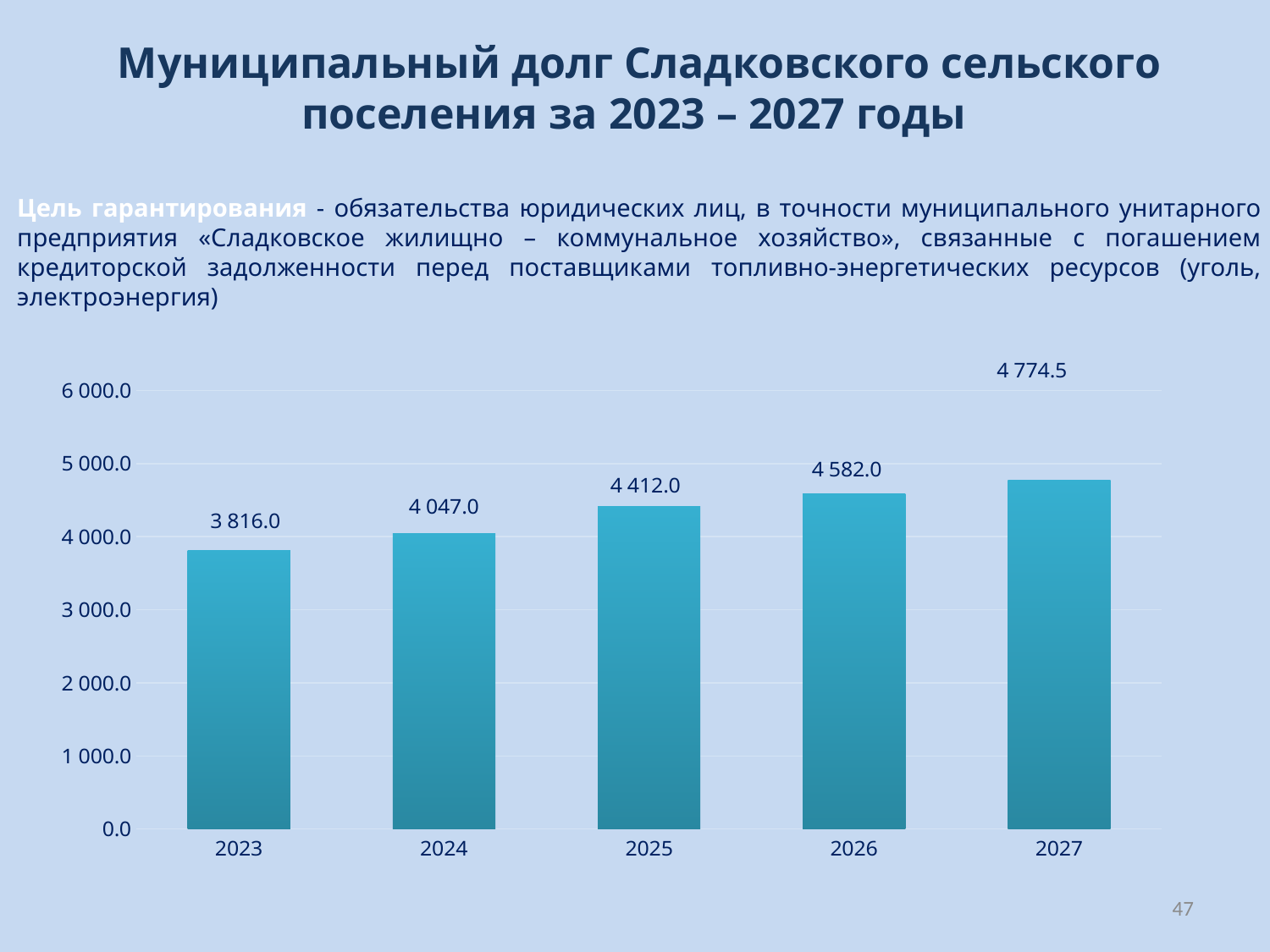
What is the value shown for 2027? 4 774.5 What is the value shown for 2023? 3 816.0 Do the values rise or fall from 2023 to 2027? rise Which year has the lowest value? 2023 What kind of chart is shown on the slide? bar chart What is the difference between the values for 2026 and 2025? 170.0 Which year has the highest value? 2027 Which is larger, the value for 2024 or the value for 2026? 2026 How many years are shown on the x axis? 5 What is the value shown for 2025? 4 412.0 What is the difference between the values for 2027 and 2023? 958.5 Is the value for 2024 greater or less than 5 000.0? less